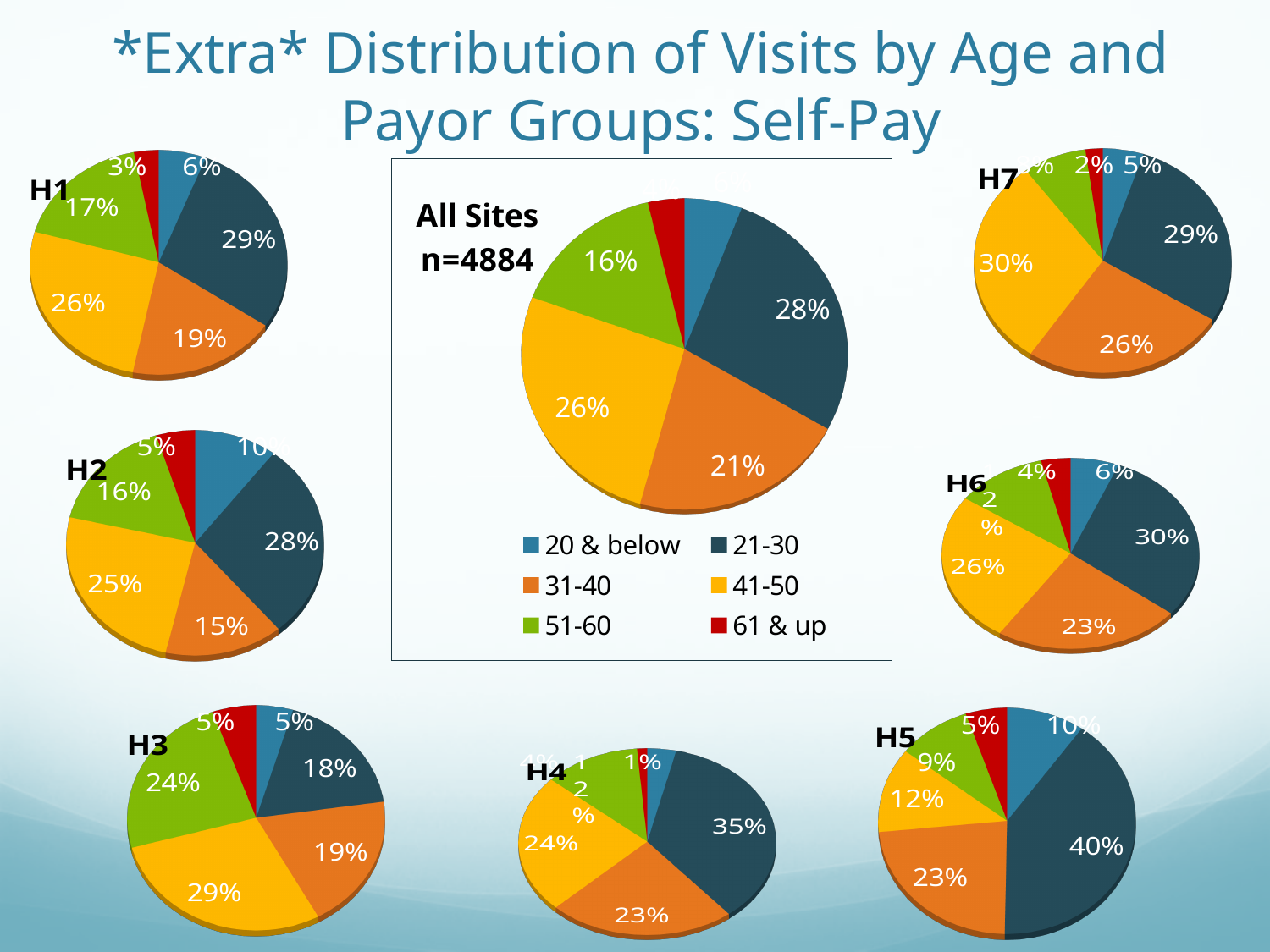
In the H5 pie chart, which age group has the largest share? 21-30 What kind of chart is used for All Sites? Pie chart In the H4 pie chart, what share of visits is for the 21-30 age group? 35% In the H7 pie chart, what share of visits is for the 41-50 age group? 30% In the H1 pie chart, what share of visits is for the 41-50 age group? 26% What is the sample size shown for the All Sites chart? n=4884 In the All Sites pie chart, what is the difference between the 41-50 share and the 31-40 share? 5% In the H5 pie chart, what share of visits is for the 21-30 age group? 40% How many age groups does the legend of the All Sites chart list? 6 In the All Sites pie chart, what share of visits is for the 41-50 age group? 26% In the H3 pie chart, which is larger, the 41-50 share or the 51-60 share? 41-50 In the All Sites pie chart, what share of visits is for the 21-30 age group? 28%